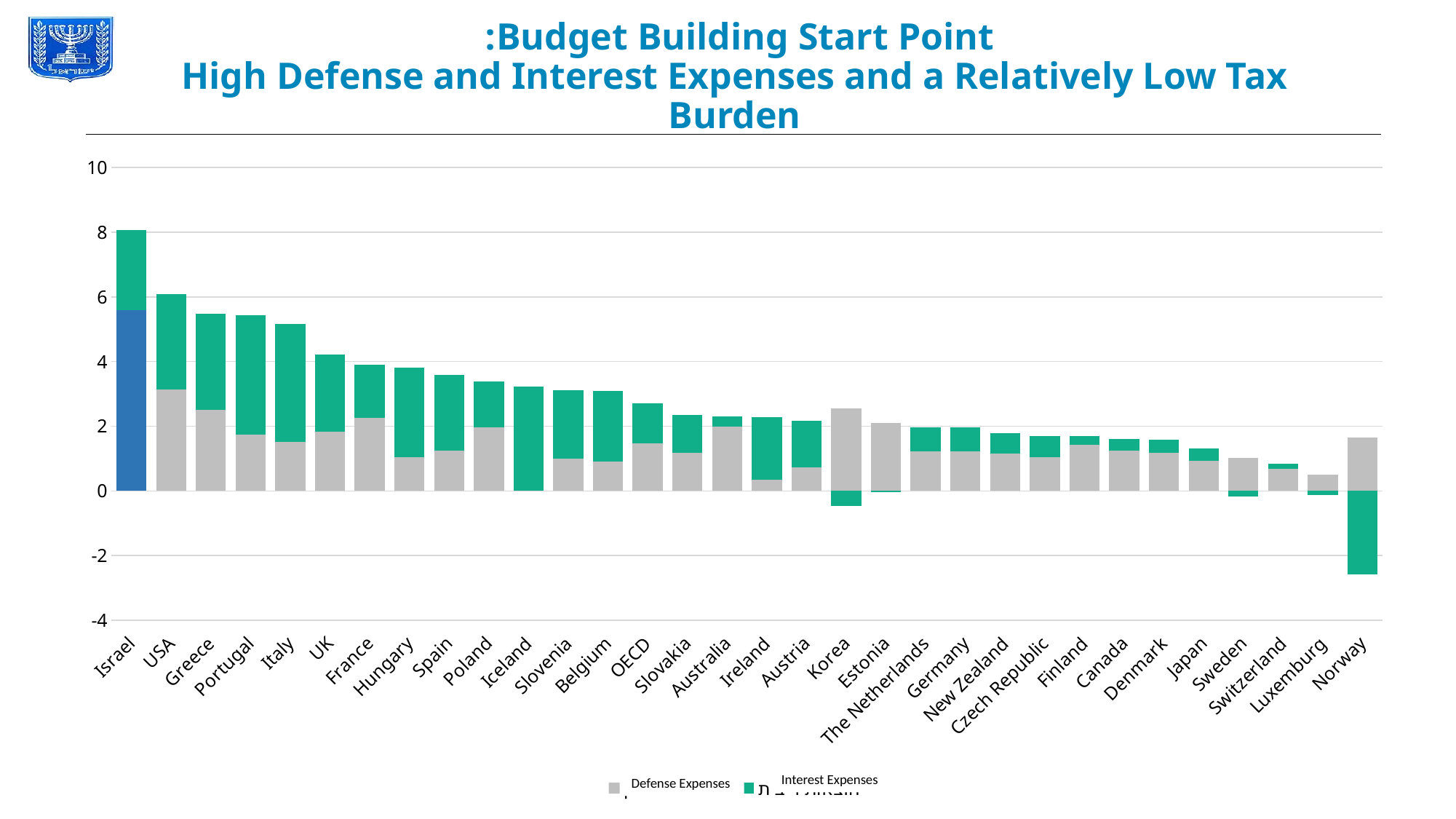
Is the total bar for Israel greater or less than 6? greater How many series does the legend list? 2 Which has the larger Defense Expenses value, Korea or Japan? Korea How many countries/categories are shown along the x axis? 32 Do the total bar heights generally rise or fall from left to right along the x axis? Fall Is the Defense Expenses value for Korea greater or less than 2? greater Which category has the lowest (most negative) Interest Expenses value? Norway What kind of chart is shown on the slide? Stacked bar chart Which has the larger total bar, Israel or USA? Israel Is the Interest Expenses value for Norway greater or less than -2? less Which category has the highest total bar? Israel